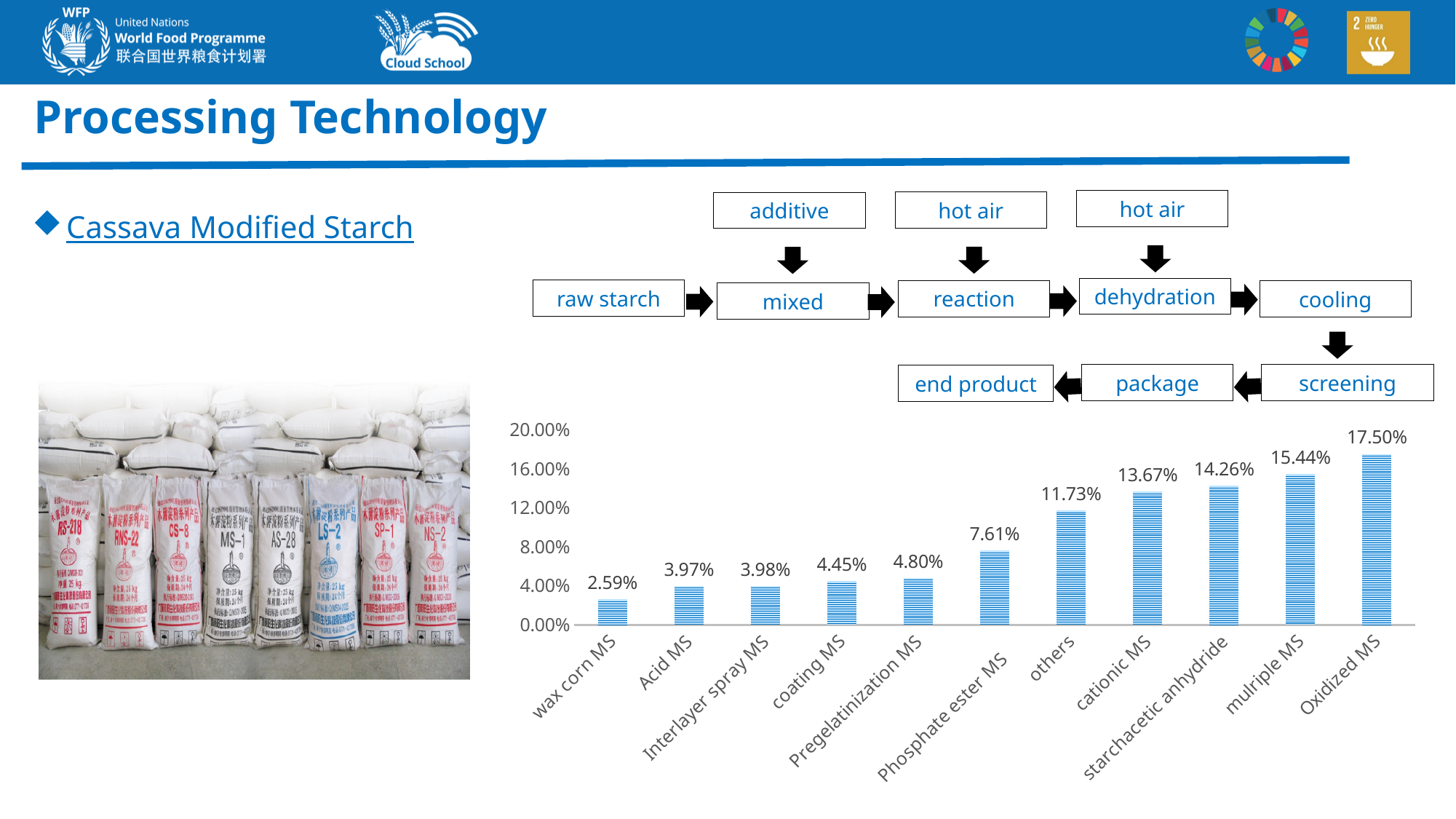
How many categories are shown in the bar chart? 11 Do the values rise or fall from left to right along the x axis? rise What is the value for cationic MS? 13.67% What is the value for Phosphate ester MS? 7.61% What is the difference between the values for Oxidized MS and mulriple MS? 2.06% Which category has the lowest value? wax corn MS What is the difference between the values for others and Phosphate ester MS? 4.12% What is the value for wax corn MS? 2.59% What kind of chart is shown on the slide? bar chart Which category has the highest value? Oxidized MS What is the value for Oxidized MS? 17.50% Which is larger, the value for starchacetic anhydride or the value for cationic MS? starchacetic anhydride